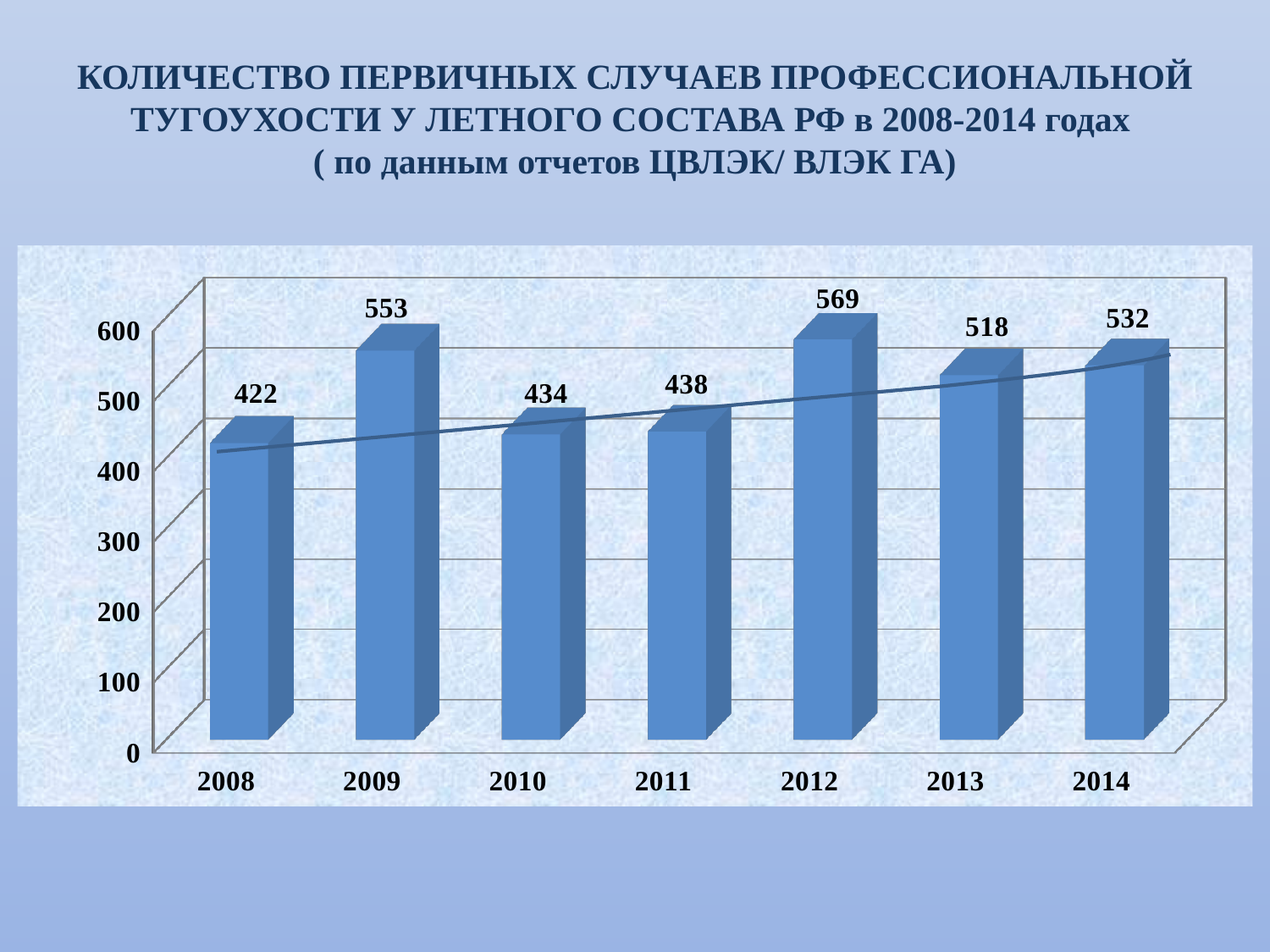
Is the value for 2010 greater or less than 500? less What is the value for 2012? 569 Which is larger, the value for 2011 or the value for 2013? 2013 What is the difference between the values for 2009 and 2010? 119 What is the value for 2014? 532 What is the value for 2008? 422 Which year has the highest value? 2012 Does the trend line drawn across the bars rise or fall from 2008 to 2014? rise How many years are shown on the x axis? 7 What is the difference between the values for 2012 and 2013? 51 What kind of chart is shown on the slide? bar chart Which year has the lowest value? 2008